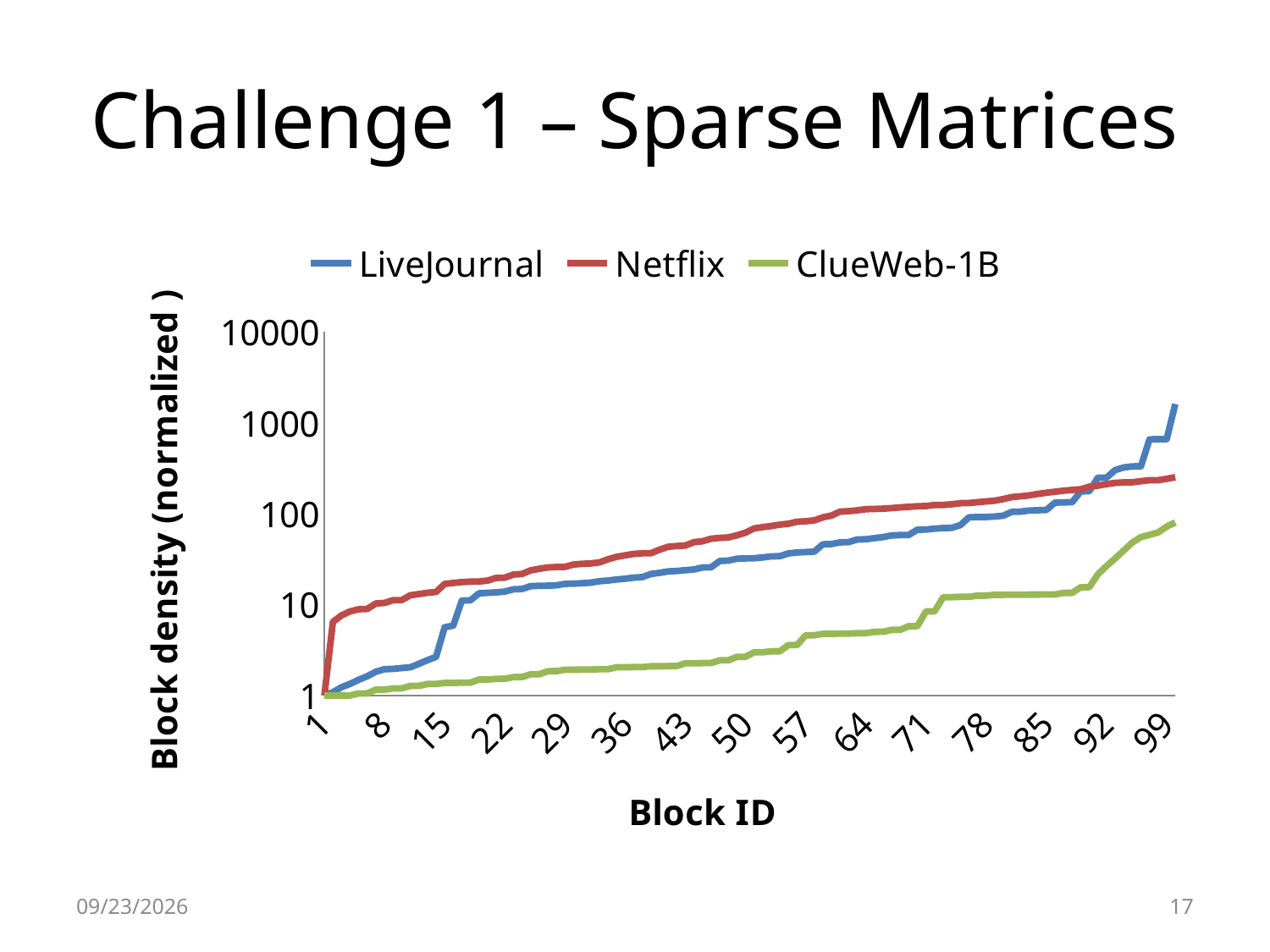
What kind of chart is shown on the slide? line chart Is the value for LiveJournal at Block ID 15 greater or less than 10? less How many series does the legend list? 3 Is the value for ClueWeb-1B at Block ID 50 greater or less than 10? less What is the title of the x axis? Block ID Which series are listed in the legend? LiveJournal, Netflix, ClueWeb-1B Is the value for LiveJournal at Block ID 99 greater or less than 100? greater Do the values for the Netflix series rise or fall as Block ID increases? rise At Block ID 50, which series has the larger value, Netflix or LiveJournal? Netflix At Block ID 99, which series has the larger value, LiveJournal or Netflix? LiveJournal Which series has the lowest block density across the chart? ClueWeb-1B